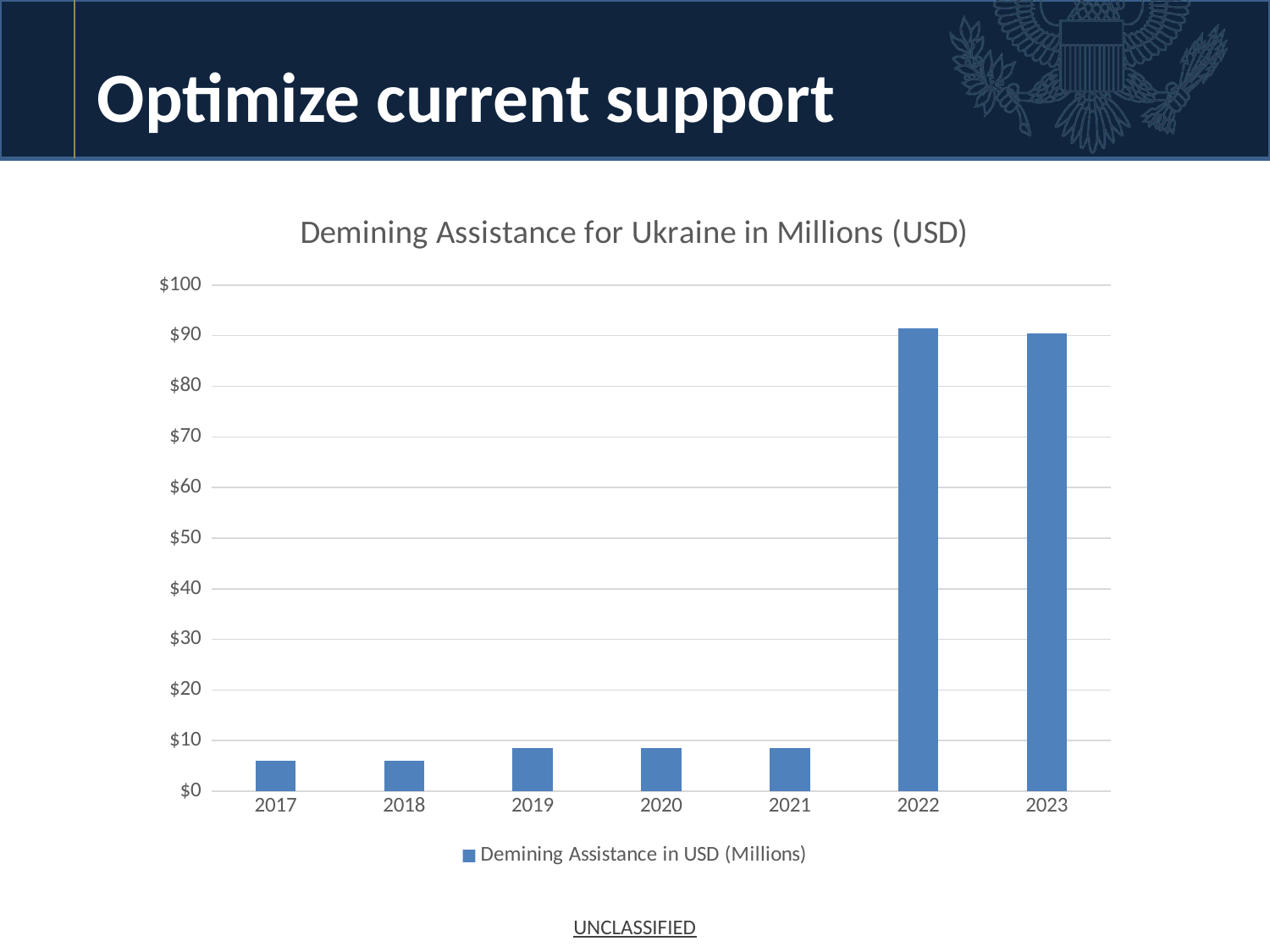
Do the values generally rise or fall from 2017 to 2023? rise What type of chart is shown on the slide? bar chart Is the value for 2022 greater or less than $90? greater Which is larger, the value for 2019 or the value for 2018? 2019 What is the legend entry for the series in the chart? Demining Assistance in USD (Millions) What is the title of the chart? Demining Assistance for Ukraine in Millions (USD) Is the value for 2023 greater or less than $80? greater Which is larger, the value for 2022 or the value for 2021? 2022 Is the value for 2017 greater or less than $10? less How many years are shown on the x axis of the chart? 7 How many series does the legend list? 1